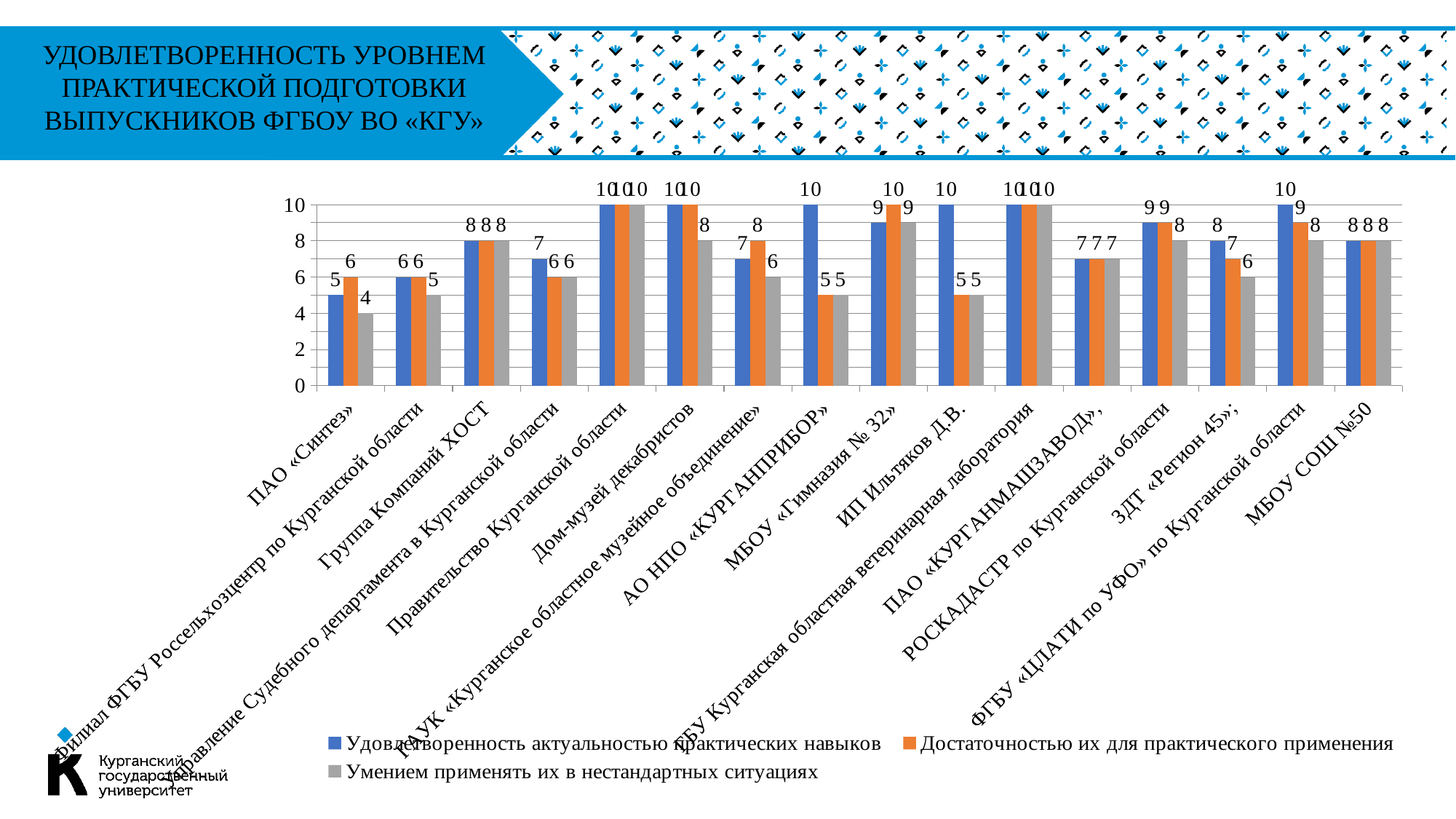
What is the difference between «Удовлетворенность актуальностью практических навыков» and «Достаточностью их для практического применения» for ИП Ильтяков Д.В.? 5 What kind of chart is shown on the slide? bar chart What is the value of «Умением применять их в нестандартных ситуациях» for ПАО «Синтез»? 4 What is the value of «Достаточностью их для практического применения» for МБОУ «Гимназия № 32»? 10 What is the value of «Удовлетворенность актуальностью практических навыков» for ЗДТ «Регион 45»? 8 What is the value of «Достаточностью их для практического применения» for АО НПО «КУРГАНПРИБОР»? 5 What is the difference between «Удовлетворенность актуальностью практических навыков» and «Умением применять их в нестандартных ситуациях» for ФГБУ «ЦЛАТИ по УФО» по Курганской области? 2 How many organisations (categories) are shown on the x axis? 16 How many series does the legend list? 3 For ГАУК «Курганское областное музейное объединение», which is larger: «Удовлетворенность актуальностью практических навыков» or «Достаточностью их для практического применения»? Достаточностью их для практического применения Which colour represents the series «Умением применять их в нестандартных ситуациях» in the legend? gray Which organisation has the lowest value for «Умением применять их в нестандартных ситуациях»? ПАО «Синтез»